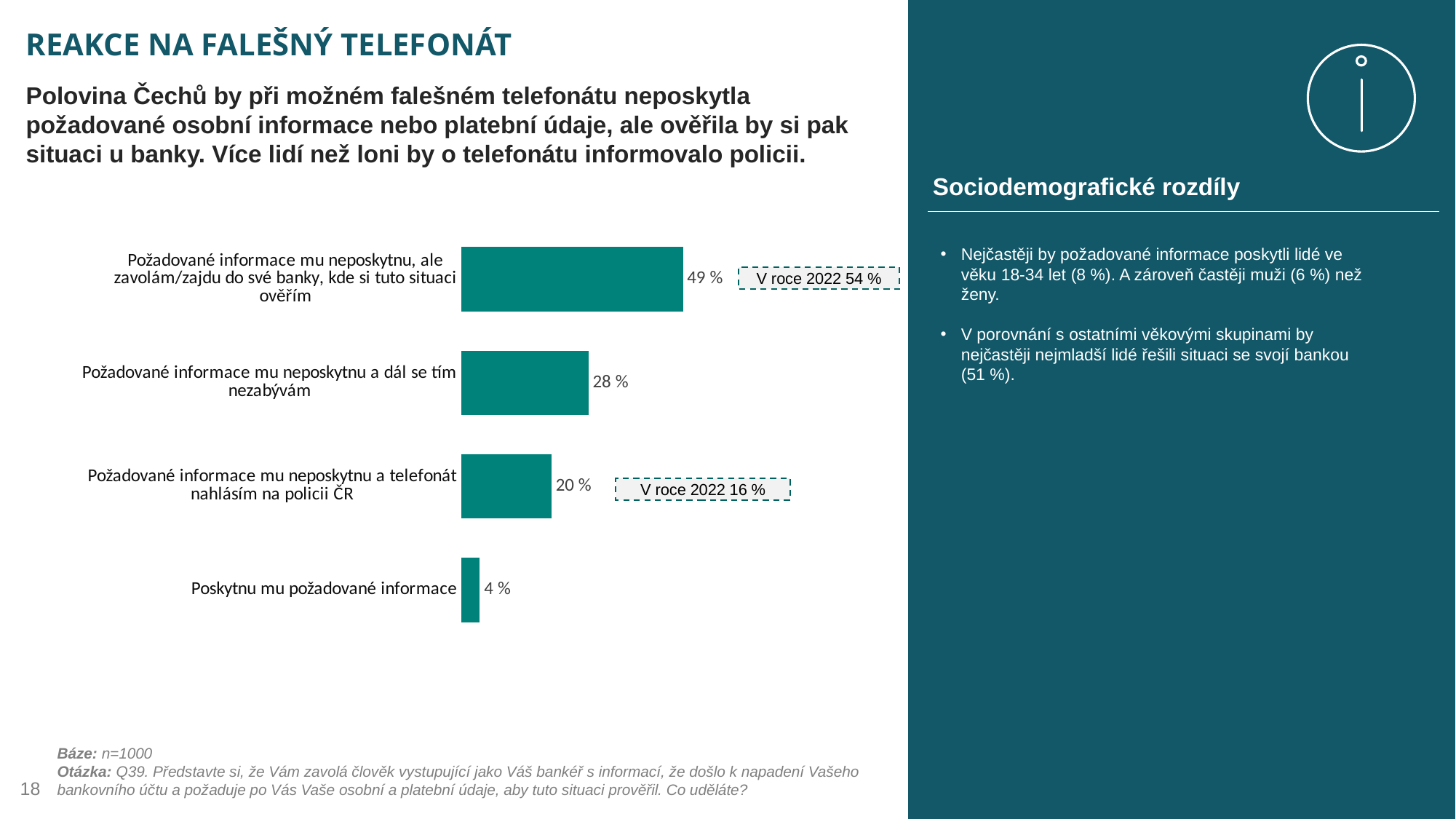
What is the value for "Požadované informace mu neposkytnu a dál se tím nezabývám"? 28 % What type of chart is shown on the slide? bar chart Which category has the highest value? Požadované informace mu neposkytnu, ale zavolám/zajdu do své banky, kde si tuto situaci ověřím What is the value for "Požadované informace mu neposkytnu, ale zavolám/zajdu do své banky, kde si tuto situaci ověřím"? 49 % Which is larger: the value for "Požadované informace mu neposkytnu a telefonát nahlásím na policii ČR" or "Poskytnu mu požadované informace"? Požadované informace mu neposkytnu a telefonát nahlásím na policii ČR According to the annotation next to the bar for "Požadované informace mu neposkytnu a telefonát nahlásím na policii ČR", what was its value in 2022? 16 % Which category has the lowest value? Poskytnu mu požadované informace What is the value for "Poskytnu mu požadované informace"? 4 % What is the value for "Požadované informace mu neposkytnu a telefonát nahlásím na policii ČR"? 20 % According to the annotation next to the top bar, what was the value for "Požadované informace mu neposkytnu, ale zavolám/zajdu do své banky, kde si tuto situaci ověřím" in 2022? 54 % What is the difference between the value for "Požadované informace mu neposkytnu a dál se tím nezabývám" and "Požadované informace mu neposkytnu a telefonát nahlásím na policii ČR"? 8 % How many categories does the bar chart show? 4